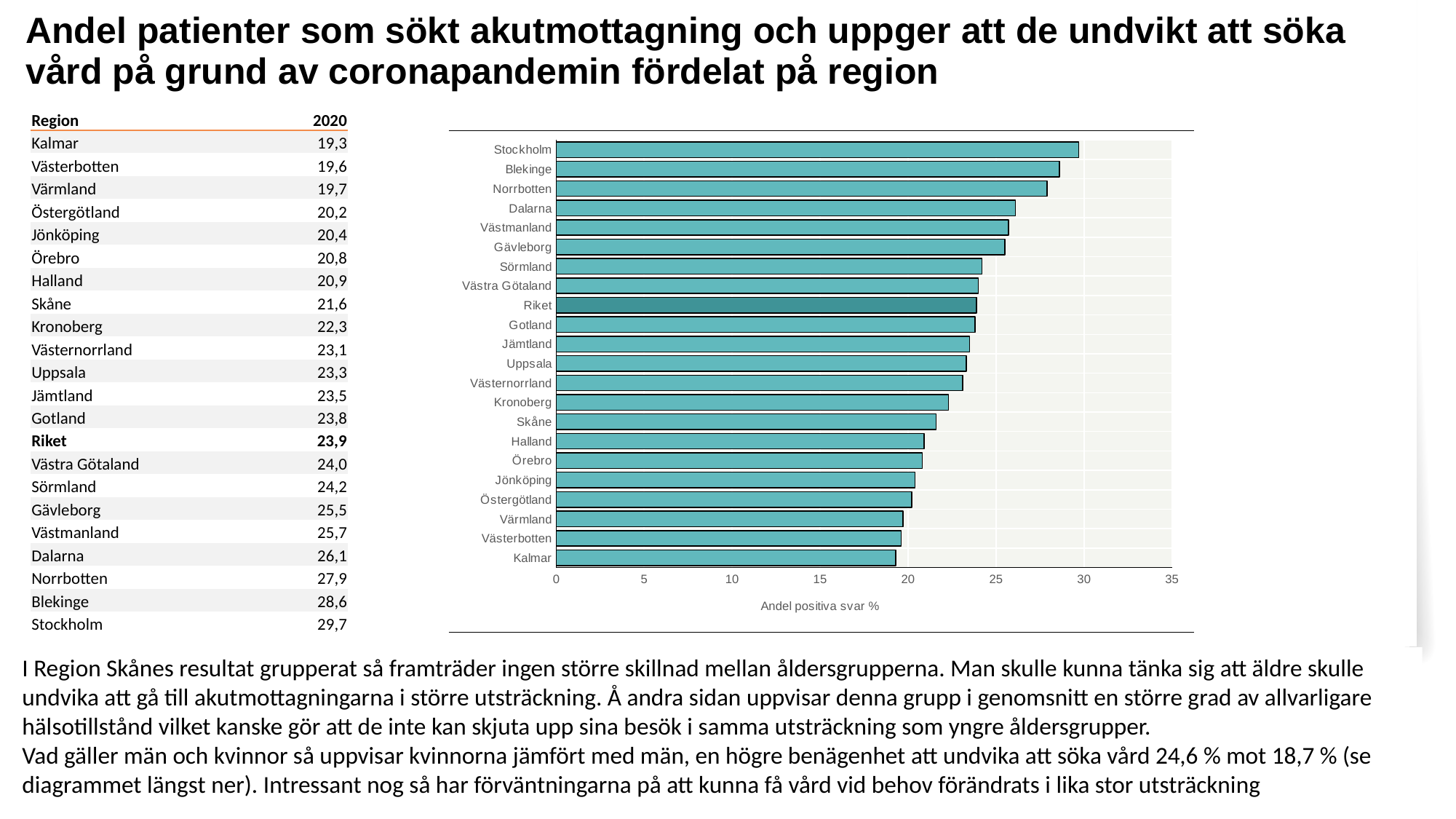
What is the difference between the values for Blekinge and Norrbotten? 0,7 Is the value for Norrbotten greater or less than 25? greater Which has a larger value, Dalarna or Gävleborg? Dalarna What is the value for Riket in 2020? 23,9 Which region has the lowest value in the chart? Kalmar Which region has the highest value in the chart? Stockholm What is the difference between the values for Stockholm and Kalmar? 10,4 How many bars are shown in the chart? 22 What kind of chart is shown on the slide? bar chart What is the label on the x axis of the chart? Andel positiva svar % What is the value for Stockholm in 2020? 29,7 What is the value for Skåne in 2020? 21,6